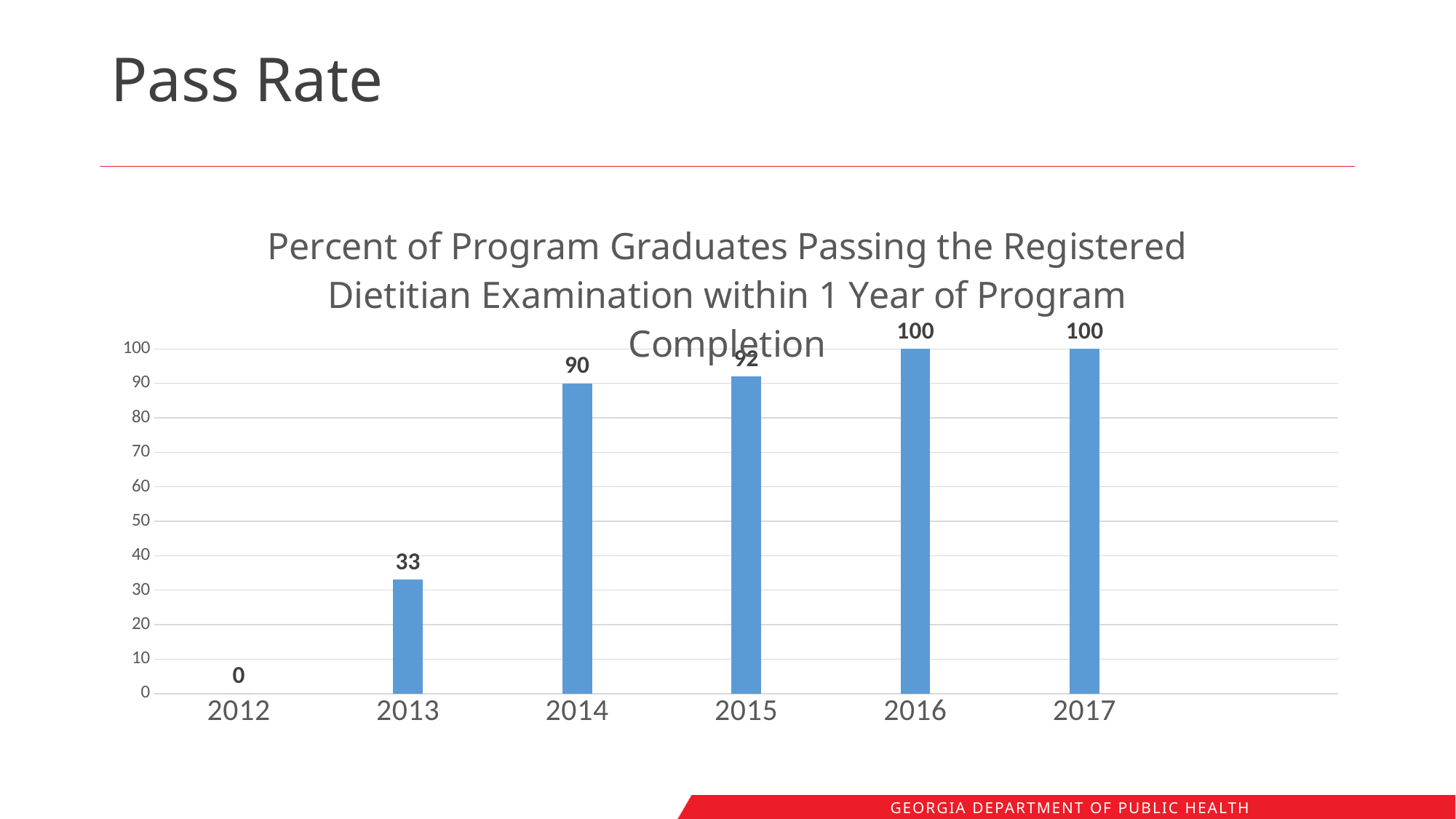
What kind of chart is shown on the slide? bar chart What is the value for 2012? 0 What is the value for 2014? 90 Do the values generally rise or fall from 2012 to 2017? rise Which is larger, the value for 2013 or the value for 2014? 2014 How many years are shown on the x axis? 6 Is the value for 2013 greater or less than 50? less What is the value for 2013? 33 What is the value for 2015? 92 Which year has the lowest value? 2012 What is the difference between the values for 2014 and 2013? 57 What is the difference between the values for 2016 and 2015? 8